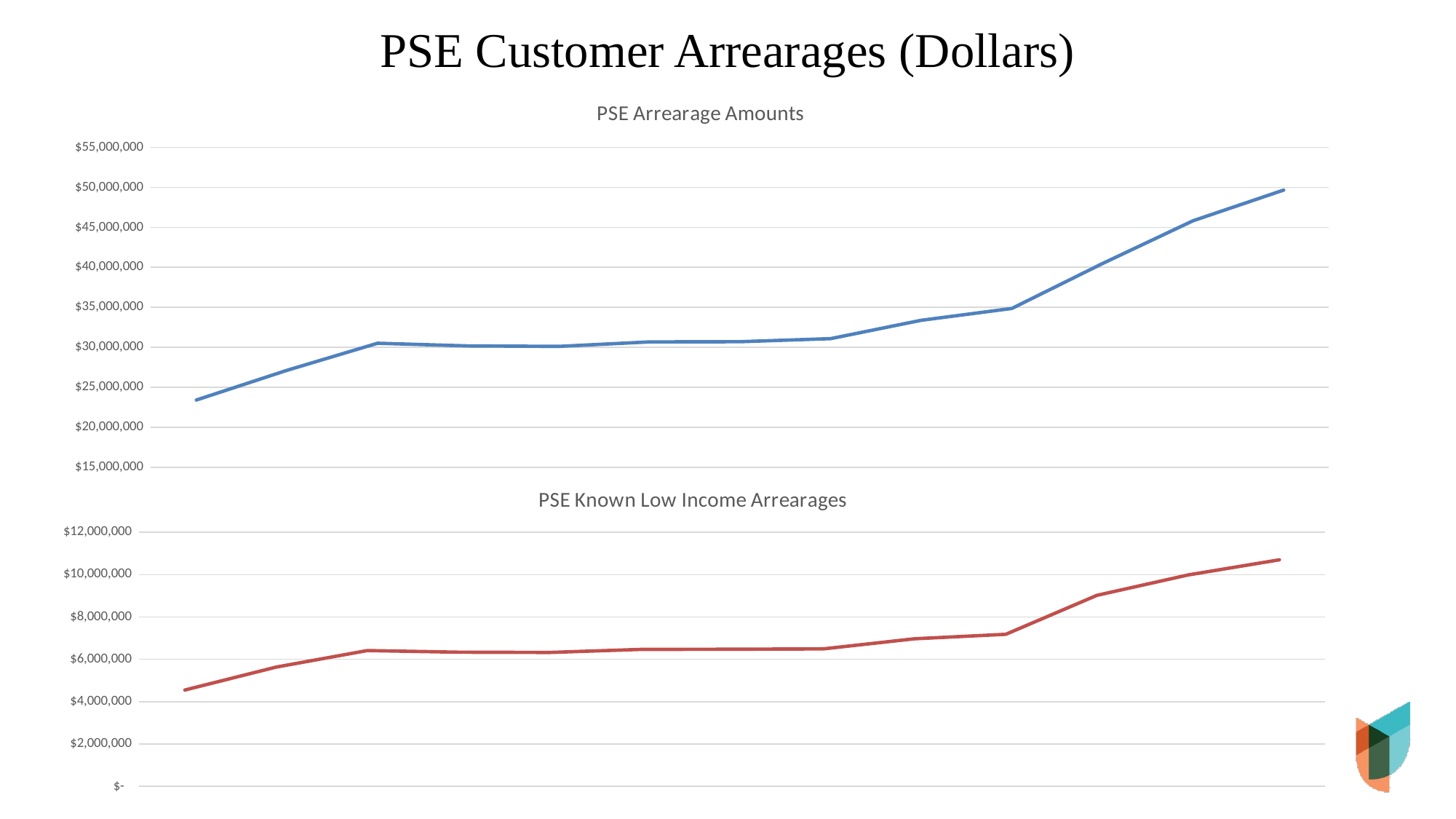
What colour is the line in the bottom chart "PSE Known Low Income Arrearages"? red In the top chart "PSE Arrearage Amounts", is the first (leftmost) value greater or less than $25,000,000? less In the bottom chart "PSE Known Low Income Arrearages", do the values generally rise or fall from left to right? rise What kind of chart is the bottom chart titled "PSE Known Low Income Arrearages"? line chart What kind of chart is the top chart titled "PSE Arrearage Amounts"? line chart In the top chart "PSE Arrearage Amounts", do the values generally rise or fall from left to right? rise In the bottom chart "PSE Known Low Income Arrearages", is the last (rightmost) value greater or less than $10,000,000? greater In the top chart "PSE Arrearage Amounts", is the last (rightmost) value greater or less than $45,000,000? greater In the top chart "PSE Arrearage Amounts", is the last (rightmost) value larger or smaller than the first (leftmost) value? larger What is the title of the slide? PSE Customer Arrearages (Dollars)